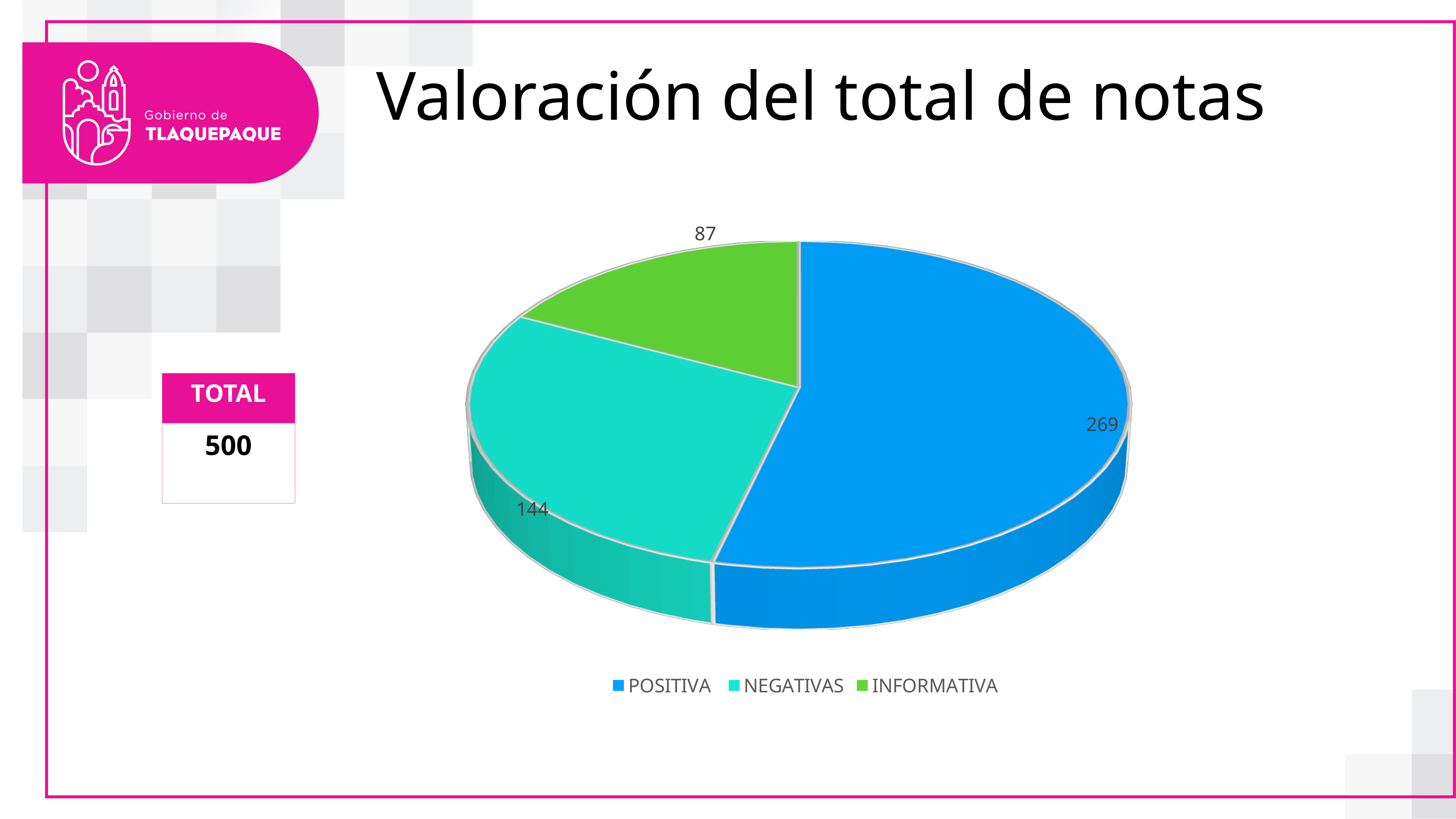
What kind of chart is shown on the slide? pie chart What is the value for NEGATIVAS? 144 Which is larger, NEGATIVAS or INFORMATIVA? NEGATIVAS What is the difference between the NEGATIVAS and INFORMATIVA values? 57 What share of the total does the POSITIVA slice represent? 53.8% What is the value for POSITIVA? 269 What is the title of the slide containing the chart? Valoración del total de notas Which category has the largest slice? POSITIVA What is the value for INFORMATIVA? 87 Which category has the smallest slice? INFORMATIVA What is the difference between the POSITIVA and NEGATIVAS values? 125 How many slices does the pie chart have? 3